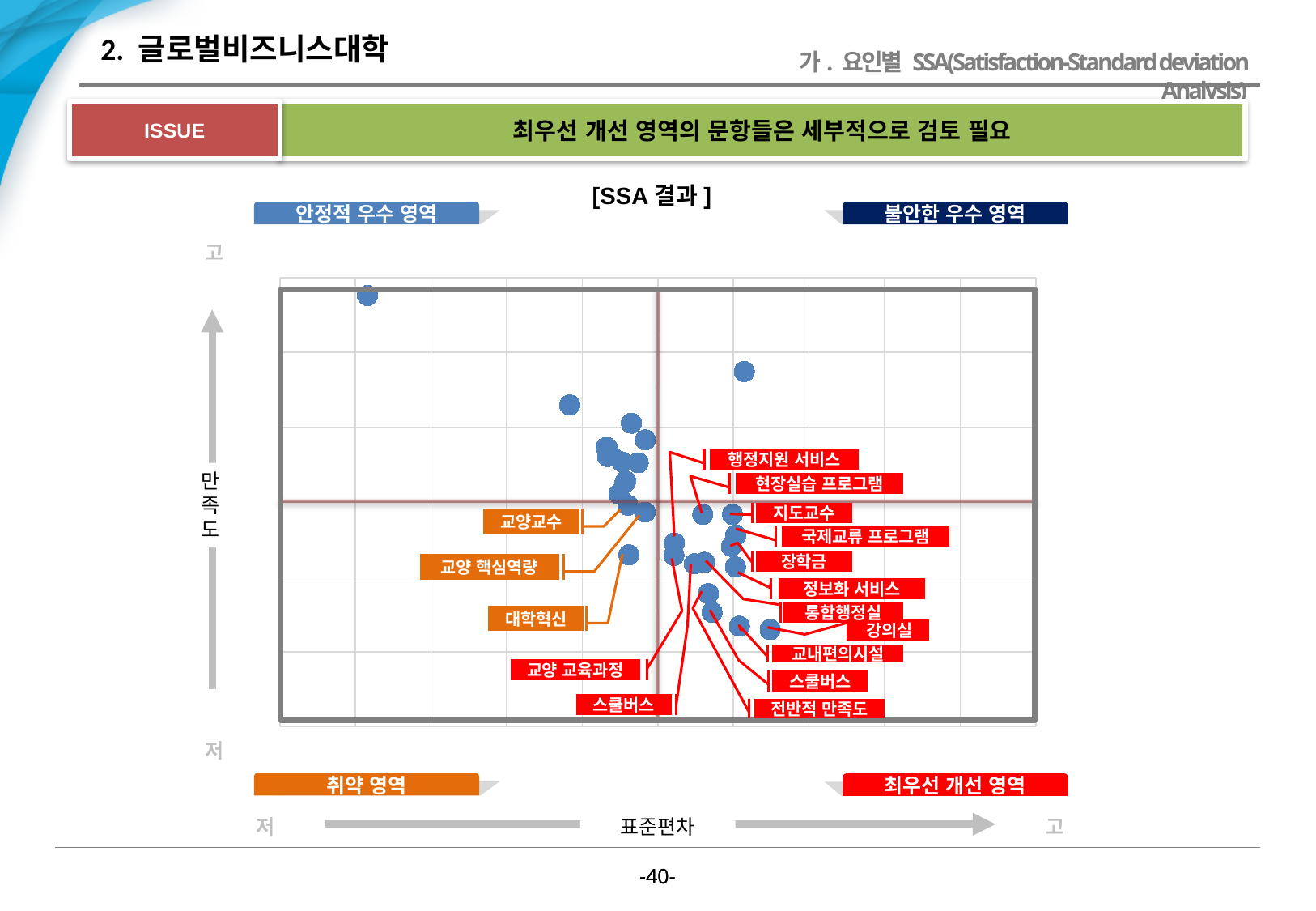
In which labelled region of the chart does 강의실 fall? 최우선 개선 영역 Which has the higher standard deviation (표준편차), 전반적 만족도 or 대학혁신? 전반적 만족도 How many items are marked with orange labels on the chart? 3 What is the title of the chart? [SSA 결과 ] Which has the higher satisfaction (만족도), 지도교수 or 대학혁신? 지도교수 What label is given to the bottom-right region of the chart? 최우선 개선 영역 Which has the higher standard deviation (표준편차), 강의실 or 교양교수? 강의실 What kind of chart is shown under the title [SSA 결과]? scatter chart In which labelled region of the chart does 대학혁신 fall? 취약 영역